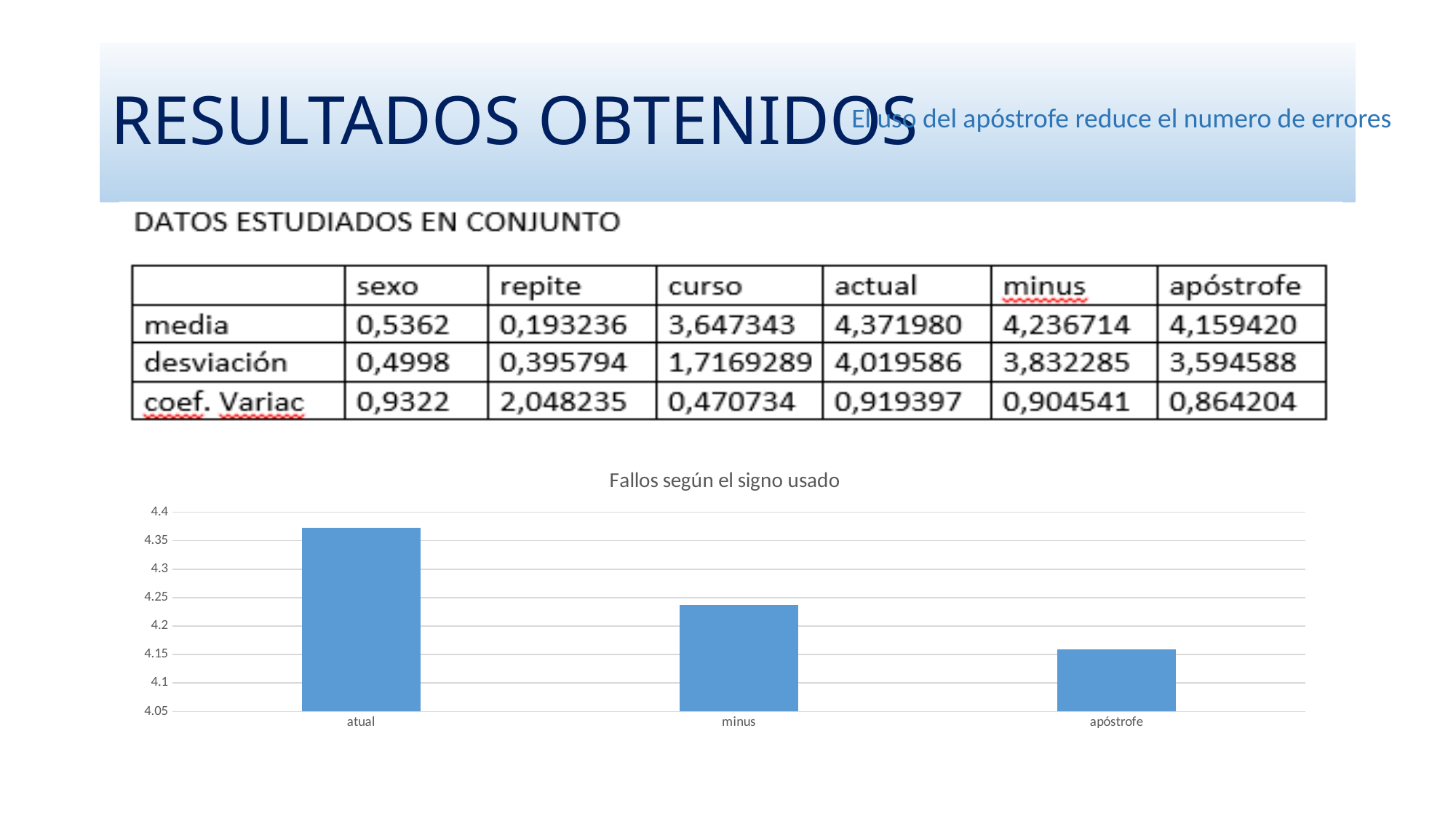
In the 'Fallos según el signo usado' chart, is the value for atual greater or less than 4.35? greater What is the lowest value shown on the y axis of the 'Fallos según el signo usado' chart? 4.05 In the 'Fallos según el signo usado' chart, which is larger, the bar for minus or the bar for apóstrofe? minus Do the bars in the 'Fallos según el signo usado' chart rise or fall from left to right? fall What is the title of the bar chart on the slide? Fallos según el signo usado In the 'Fallos según el signo usado' chart, is the value for apóstrofe greater or less than 4.2? less How many categories are plotted in the 'Fallos según el signo usado' chart? 3 Which category has the highest bar in the 'Fallos según el signo usado' chart? atual Which category has the lowest bar in the 'Fallos según el signo usado' chart? apóstrofe What kind of chart is shown under the title 'Fallos según el signo usado'? bar chart In the 'Fallos según el signo usado' chart, is the value for minus greater or less than 4.25? less